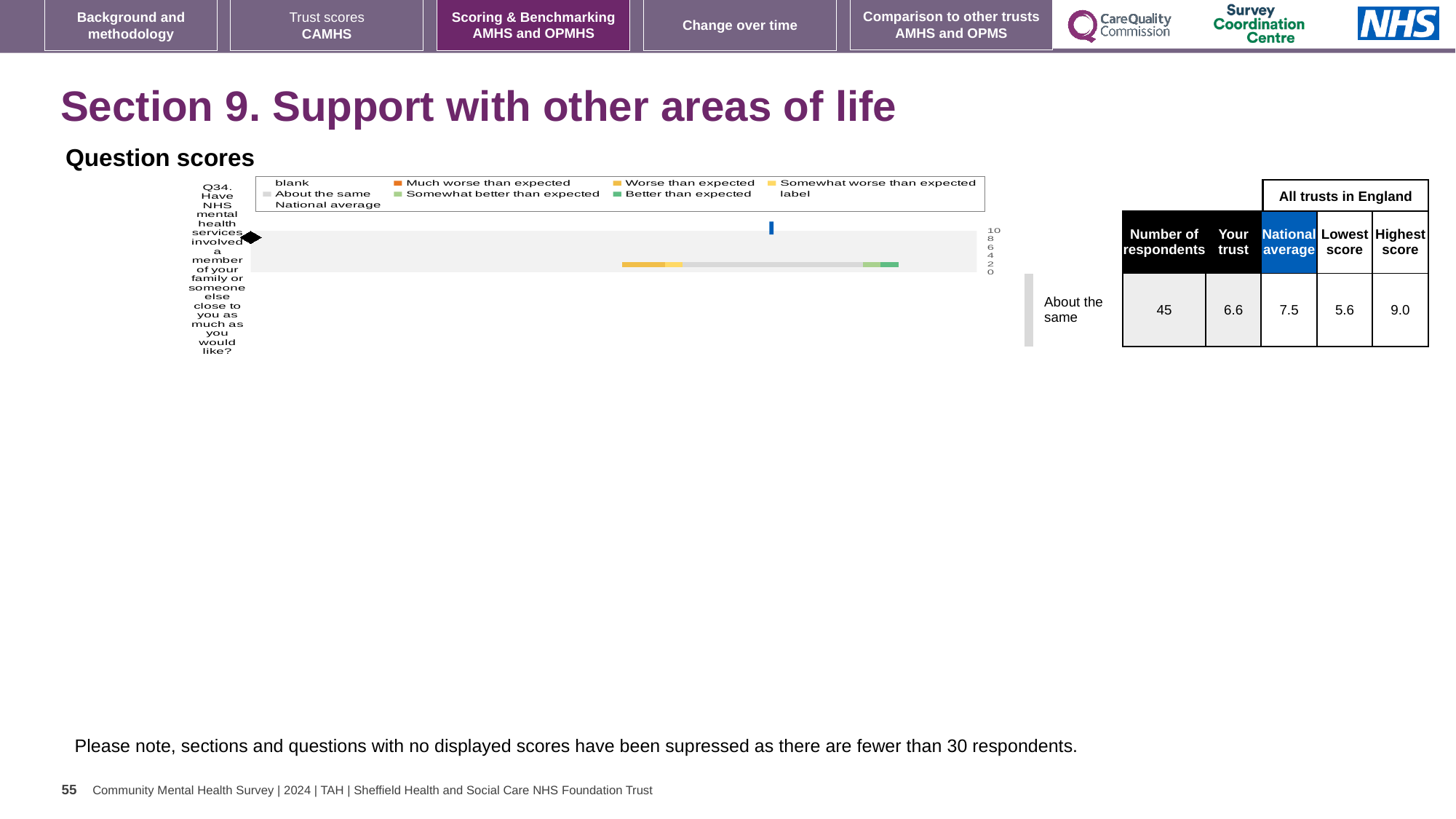
What is the difference between the National average and the 'Your trust' score for Q34? 0.9 Which question number is plotted in the Question scores chart? Q34 What is the highest value shown on the score axis of the Question scores chart? 10 What kind of chart is shown under 'Question scores'? bar chart What is the National average score for Q34? 7.5 Which is larger for Q34, the 'Your trust' score or the National average? National average How many respondents answered Q34? 45 What is the Lowest score among all trusts in England for Q34? 5.6 What is the 'Your trust' score for Q34? 6.6 What benchmark category is given for Q34? About the same What is the Highest score among all trusts in England for Q34? 9.0 How many survey questions are plotted in the Question scores chart? 1